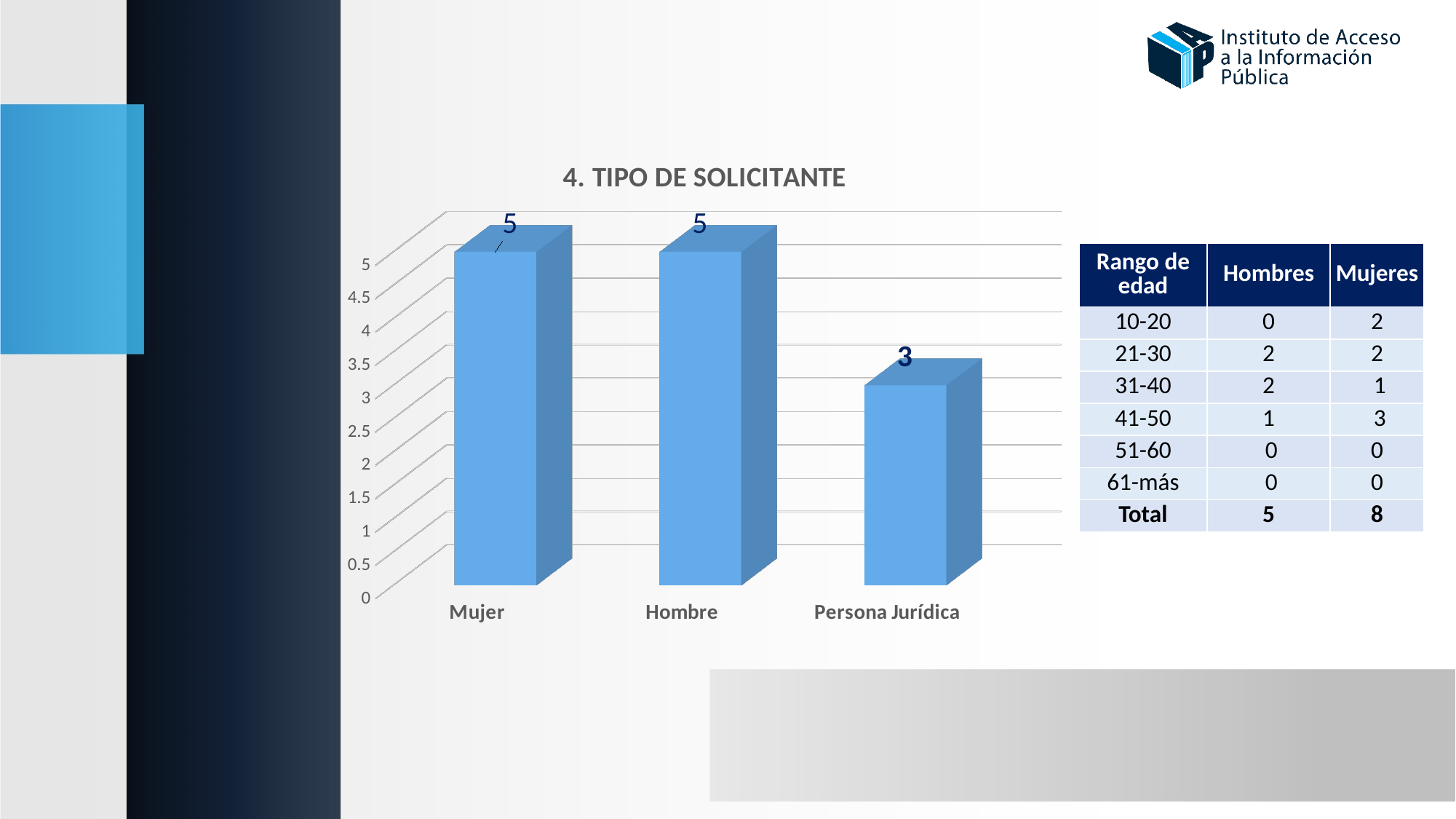
What is the value for Persona Jurídica in the chart? 3 Which is larger, the value for Mujer or the value for Persona Jurídica? Mujer How many categories are shown in the chart? 3 Which category has the lowest value in the chart? Persona Jurídica What is the value for Hombre in the chart? 5 What is the highest value shown on the chart's vertical axis? 5 What is the difference between the values for Hombre and Persona Jurídica? 2 Is the value for Hombre greater or less than 4? greater Is the value for Persona Jurídica greater or less than 4? less What is the value for Mujer in the chart? 5 What is the title of the chart? 4. TIPO DE SOLICITANTE What kind of chart is shown on the slide? bar chart